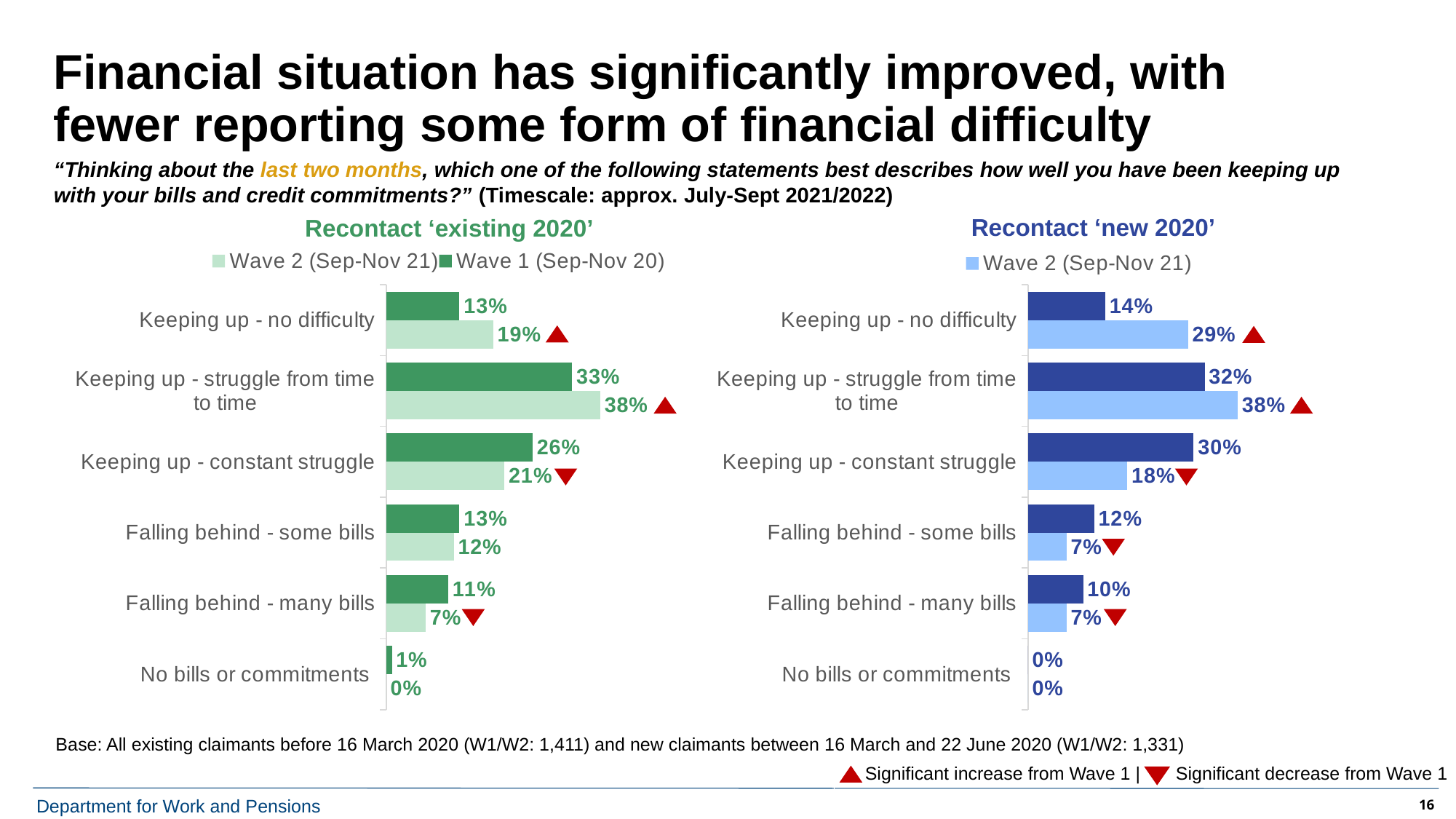
In the 'Recontact ‘existing 2020’' chart, what is the Wave 1 (Sep-Nov 20) value for 'Keeping up - constant struggle'? 26% What type of chart is the 'Recontact ‘existing 2020’' chart? Bar chart In the 'Recontact ‘new 2020’' chart, what is the difference between the Wave 2 (Sep-Nov 21) values for 'Keeping up - struggle from time to time' and 'Keeping up - constant struggle'? 20% In the 'Recontact ‘existing 2020’' chart, what is the Wave 2 (Sep-Nov 21) value for 'Keeping up - no difficulty'? 19% In the 'Recontact ‘new 2020’' chart, what is the Wave 2 (Sep-Nov 21) value for 'Falling behind - some bills'? 7% In the 'Recontact ‘existing 2020’' chart, what is the difference between the Wave 1 (Sep-Nov 20) and Wave 2 (Sep-Nov 21) values for 'Keeping up - no difficulty'? 6% In the 'Recontact ‘existing 2020’' chart, which category has the highest Wave 2 (Sep-Nov 21) value? Keeping up - struggle from time to time How many categories are shown in the 'Recontact ‘new 2020’' chart? 6 In the 'Recontact ‘existing 2020’' chart, which is larger for 'Falling behind - many bills': the Wave 1 (Sep-Nov 20) value or the Wave 2 (Sep-Nov 21) value? Wave 1 (Sep-Nov 20) In the 'Recontact ‘existing 2020’' chart, which category has the lowest Wave 1 (Sep-Nov 20) value? No bills or commitments How many series does the legend of the 'Recontact ‘existing 2020’' chart list? 2 In the 'Recontact ‘new 2020’' chart, what is the Wave 2 (Sep-Nov 21) value for 'Keeping up - no difficulty'? 29%